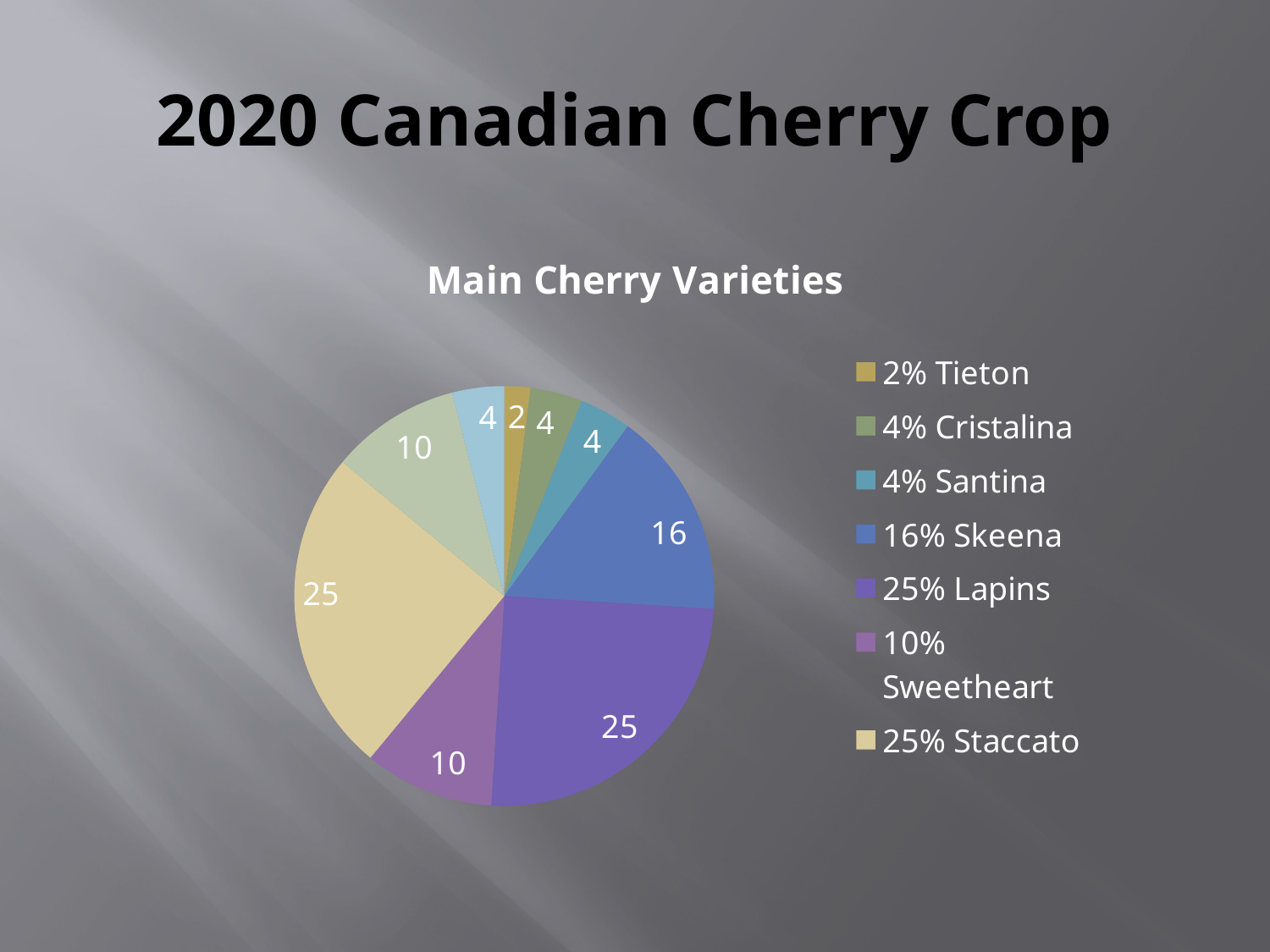
What is the value shown for the Skeena slice? 16 What kind of chart is shown on the slide? pie chart What is the value shown for the Tieton slice? 2 How many entries does the legend list? 7 Which is larger, the Skeena slice or the Sweetheart slice? Skeena What is the title of the chart? Main Cherry Varieties How many slices does the pie chart have? 9 What is the difference between the Staccato value and the Sweetheart value? 15 According to the legend, what percentage share of the pie is Skeena? 16% Which variety has the smallest slice of the pie? Tieton What is the value shown for the Lapins slice? 25 What is the difference between the Lapins value and the Skeena value? 9